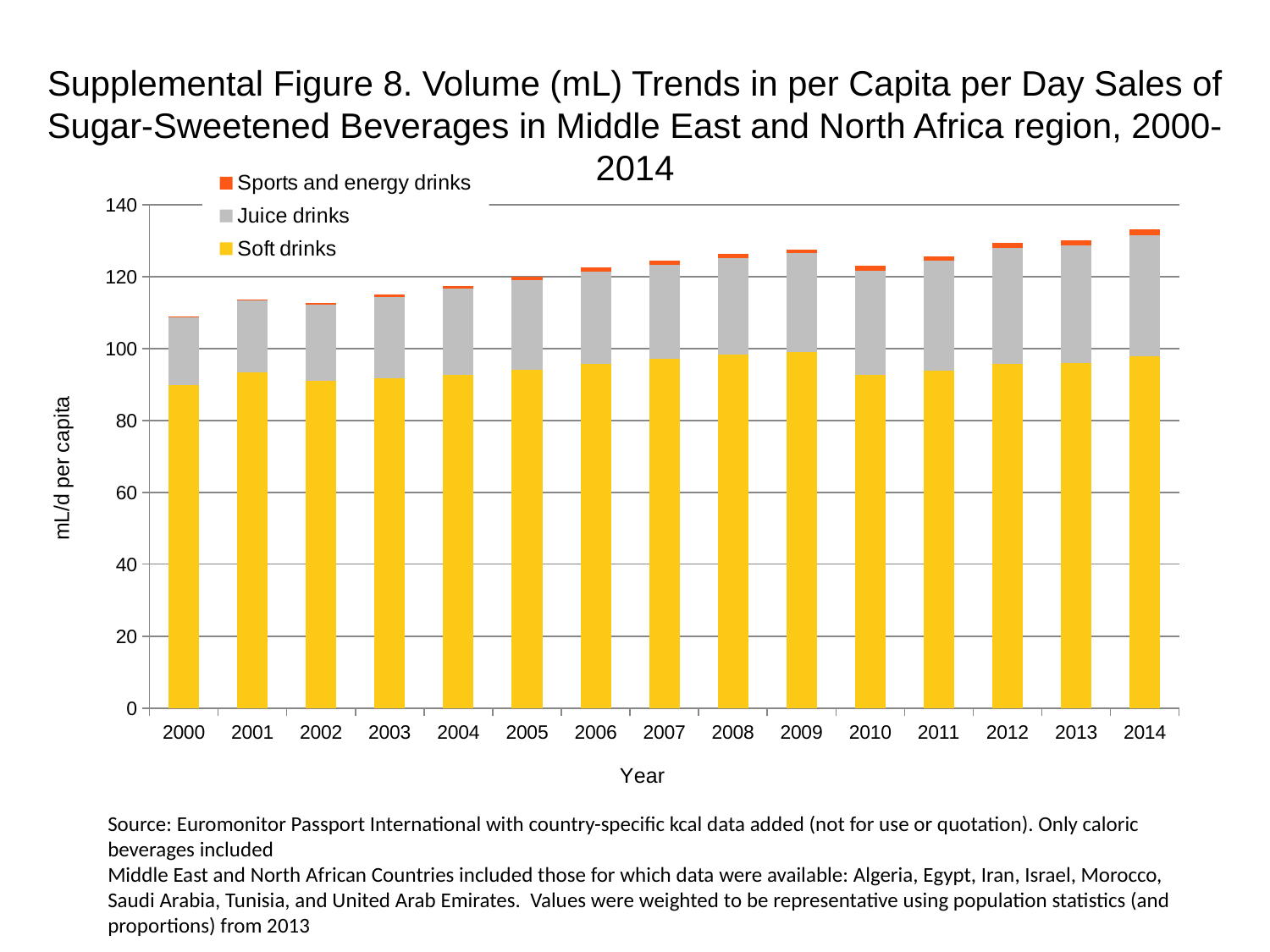
Do the total bar heights generally rise or fall from 2000 to 2014? rise What is the label on the vertical axis of the chart? mL/d per capita Which year has the lowest total bar in the chart? 2000 Is the Soft drinks value for 2000 greater or less than 100? less What kind of chart is shown on the slide? Stacked bar chart Which year has the larger total bar, 2009 or 2010? 2009 How many series does the chart's legend list? 3 How many years are shown along the x axis of the chart? 15 Is the total bar for 2014 greater or less than 120? greater Is the total bar for 2000 greater or less than 120? less Which year has the highest total bar in the chart? 2014